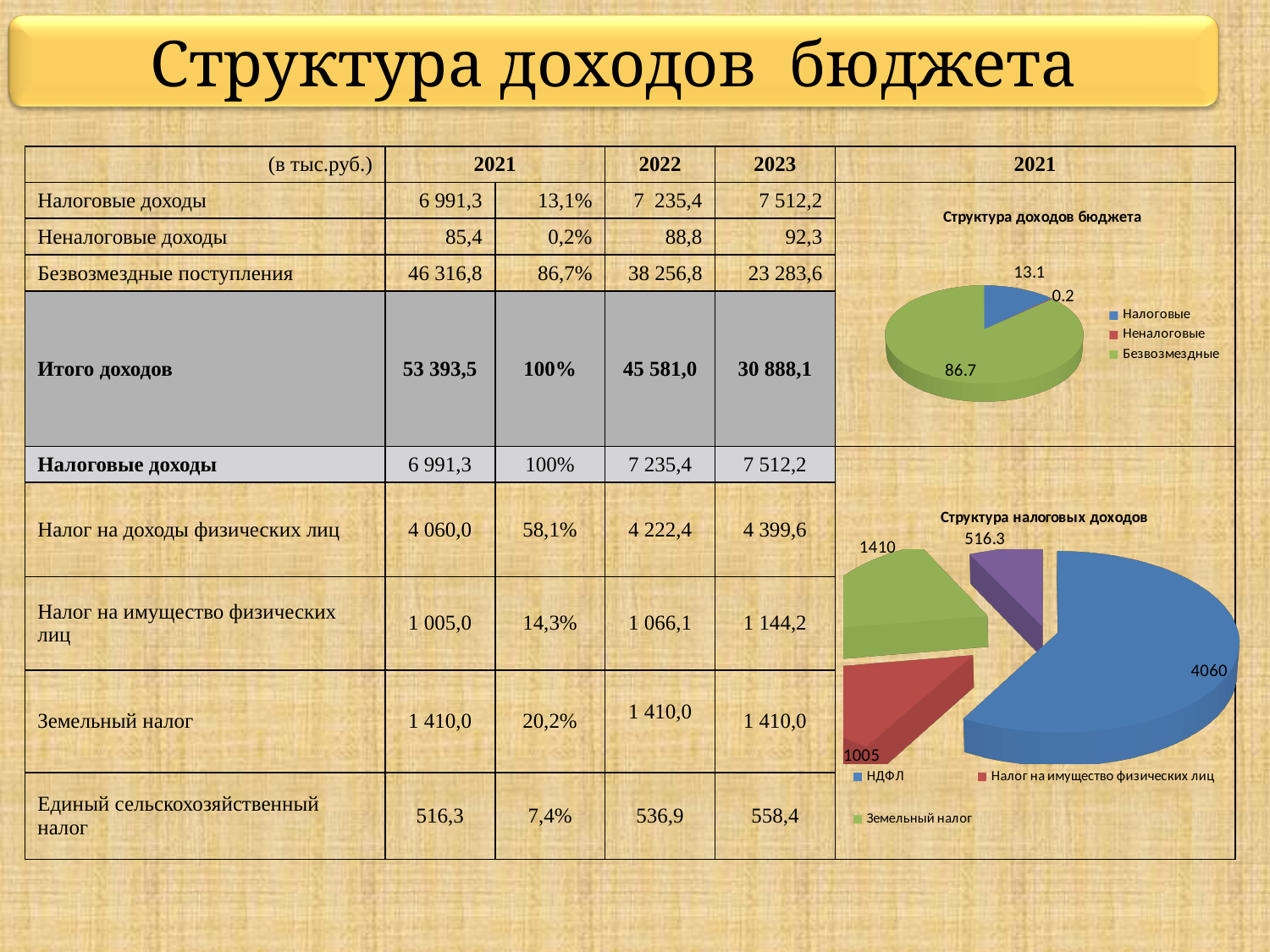
In the bottom chart 'Структура налоговых доходов', which is larger: Земельный налог or Налог на имущество физических лиц? Земельный налог What kind of chart is the top chart titled 'Структура доходов бюджета'? pie chart In the top chart 'Структура доходов бюджета', how many entries does the legend list? 3 In the bottom chart 'Структура налоговых доходов', what is the value shown for Земельный налог? 1410 In the top chart 'Структура доходов бюджета', which category has the smallest slice? Неналоговые In the bottom chart 'Структура налоговых доходов', which category has the largest slice? НДФЛ In the bottom chart 'Структура налоговых доходов', what is the value shown for НДФЛ? 4060 In the top chart 'Структура доходов бюджета', what is the difference between the values for Безвозмездные and Налоговые? 73.6 In the top chart 'Структура доходов бюджета', what is the value shown for Безвозмездные? 86.7 In the top chart 'Структура доходов бюджета', what is the value shown for Налоговые? 13.1 In the top chart 'Структура доходов бюджета', which category has the largest slice? Безвозмездные In the bottom chart 'Структура налоговых доходов', what is the value shown for Налог на имущество физических лиц? 1005